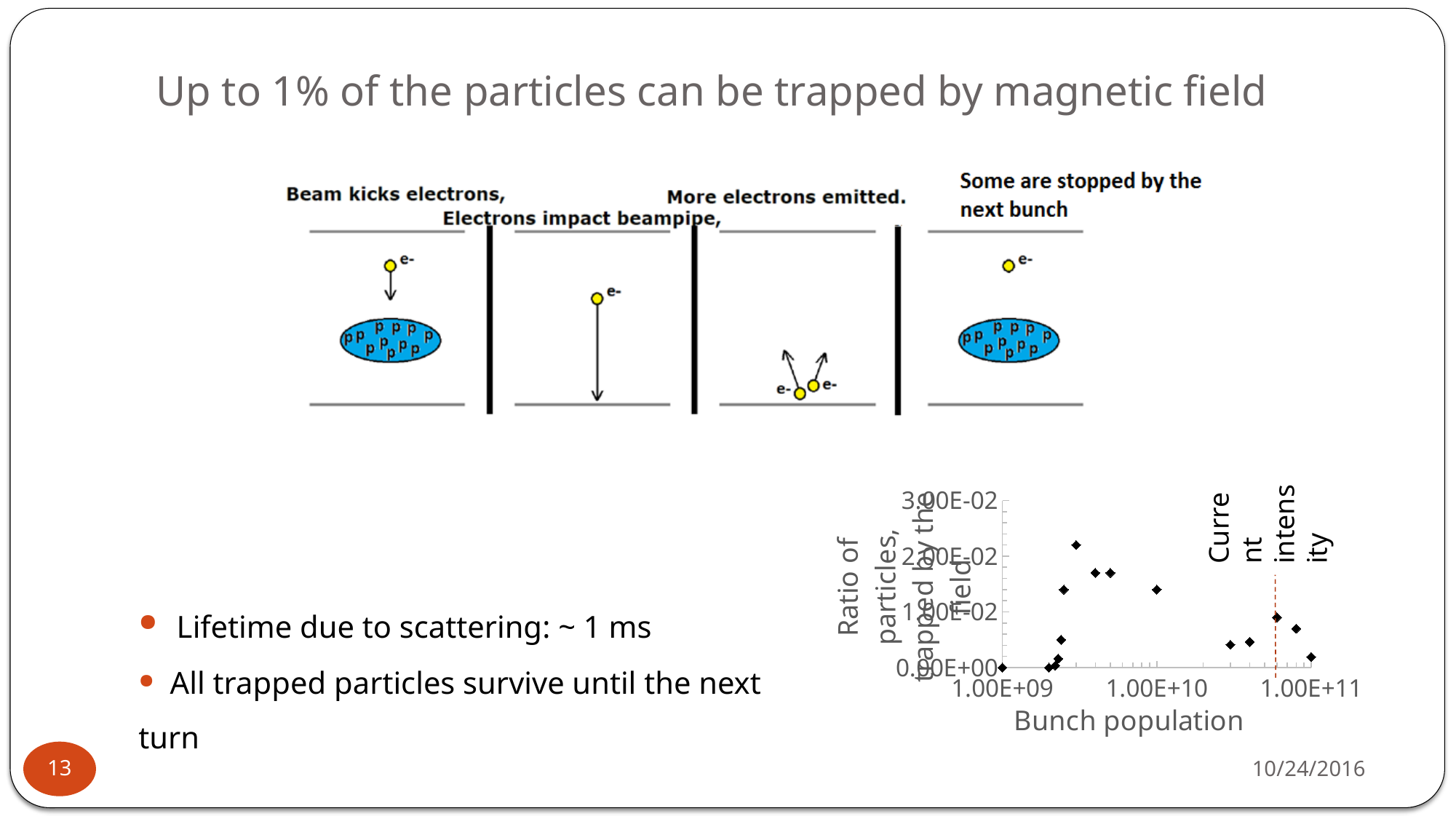
Is the highest plotted ratio in the scatter chart greater or less than 2.00E-02? greater Is the highest plotted ratio in the scatter chart greater or less than 3.00E-02? less How does the ratio of trapped particles change as bunch population increases from 1.00E+10 to 1.00E+11 in the scatter chart? It generally falls Which is larger in the scatter chart: the ratio at a bunch population of about 1.00E+10 or the ratio at the rightmost point near 1.00E+11? The ratio at about 1.00E+10 What does the red dashed vertical line in the scatter chart mark? Current intensity What kind of chart is shown at the bottom right of the slide? Scatter chart Is the ratio of trapped particles at a bunch population of 1.00E+09 greater or less than 1.00E-02? less What is the title of the x axis of the scatter chart? Bunch population How many data series are plotted in the scatter chart? 1 What is the highest value shown on the y axis of the scatter chart? 3.00E-02